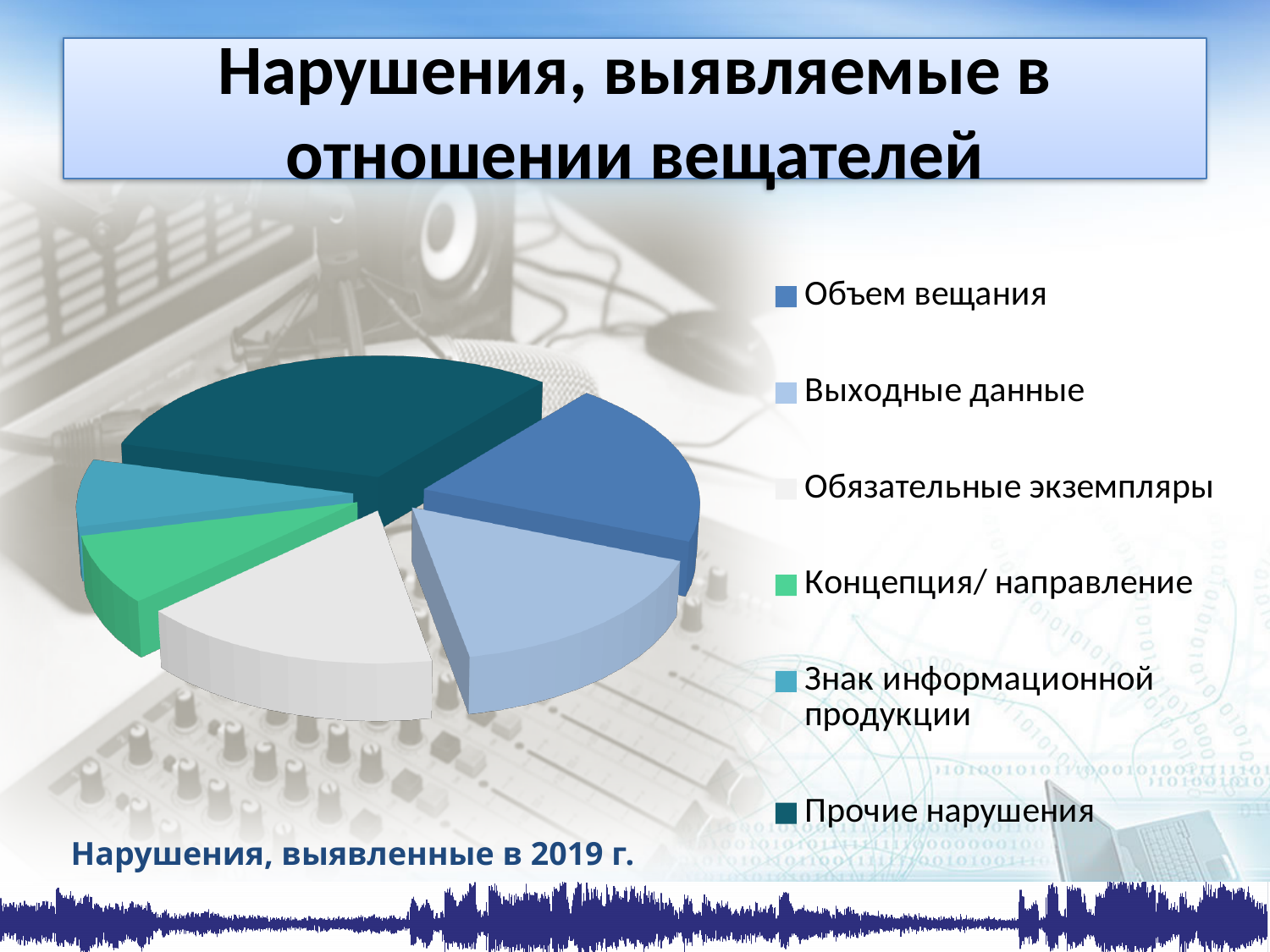
What caption appears below the pie chart? Нарушения, выявленные в 2019 г. Which slice is larger: Прочие нарушения or Концепция/ направление? Прочие нарушения Which category has the largest slice of the pie chart? Прочие нарушения How many entries does the chart legend list? 6 How many slices does the pie chart have? 6 Which slice is larger: Объем вещания or Знак информационной продукции? Объем вещания What is the title of the slide containing the pie chart? Нарушения, выявляемые в отношении вещателей Which slice is larger: Выходные данные or Концепция/ направление? Выходные данные What kind of chart is shown on the slide? pie chart